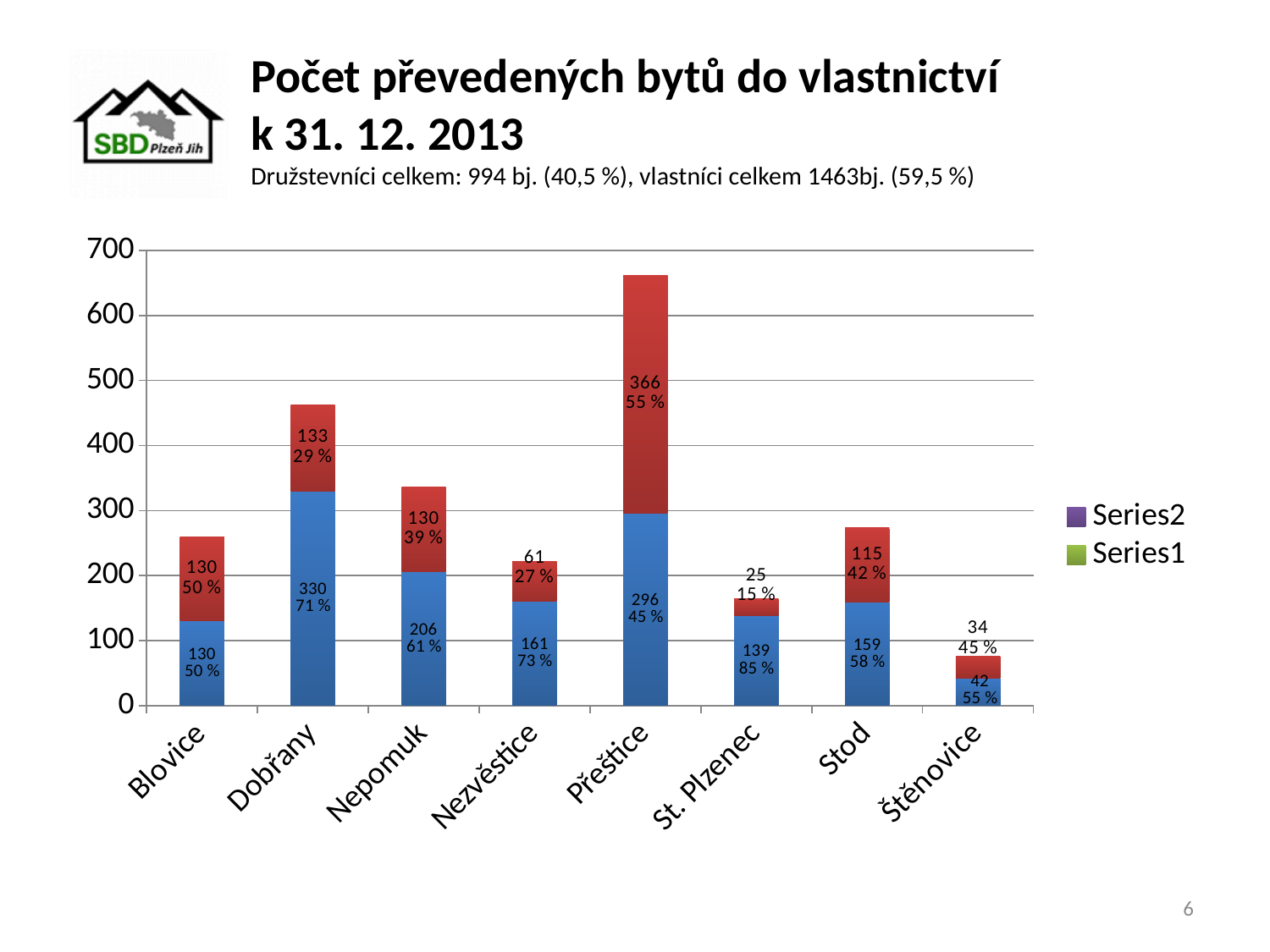
What type of chart is shown on the slide? stacked bar chart How many series does the legend list? 2 What is the difference between the blue segment value for Dobřany and the blue segment value for Nepomuk? 124 Which is larger: the red segment for Stod or the red segment for Nezvěstice? Stod Is the total stacked bar for Přeštice greater or less than 600? greater Which town has the shortest stacked bar overall? Štěnovice What is the value of the blue (bottom) segment for Dobřany? 330 What is the total of the stacked bar for Blovice? 260 What percentage is shown on the blue (bottom) segment for St. Plzenec? 85 % What is the value of the red (top) segment for Přeštice? 366 Which town has the tallest stacked bar overall? Přeštice How many categories (towns) are shown on the x axis of the chart? 8